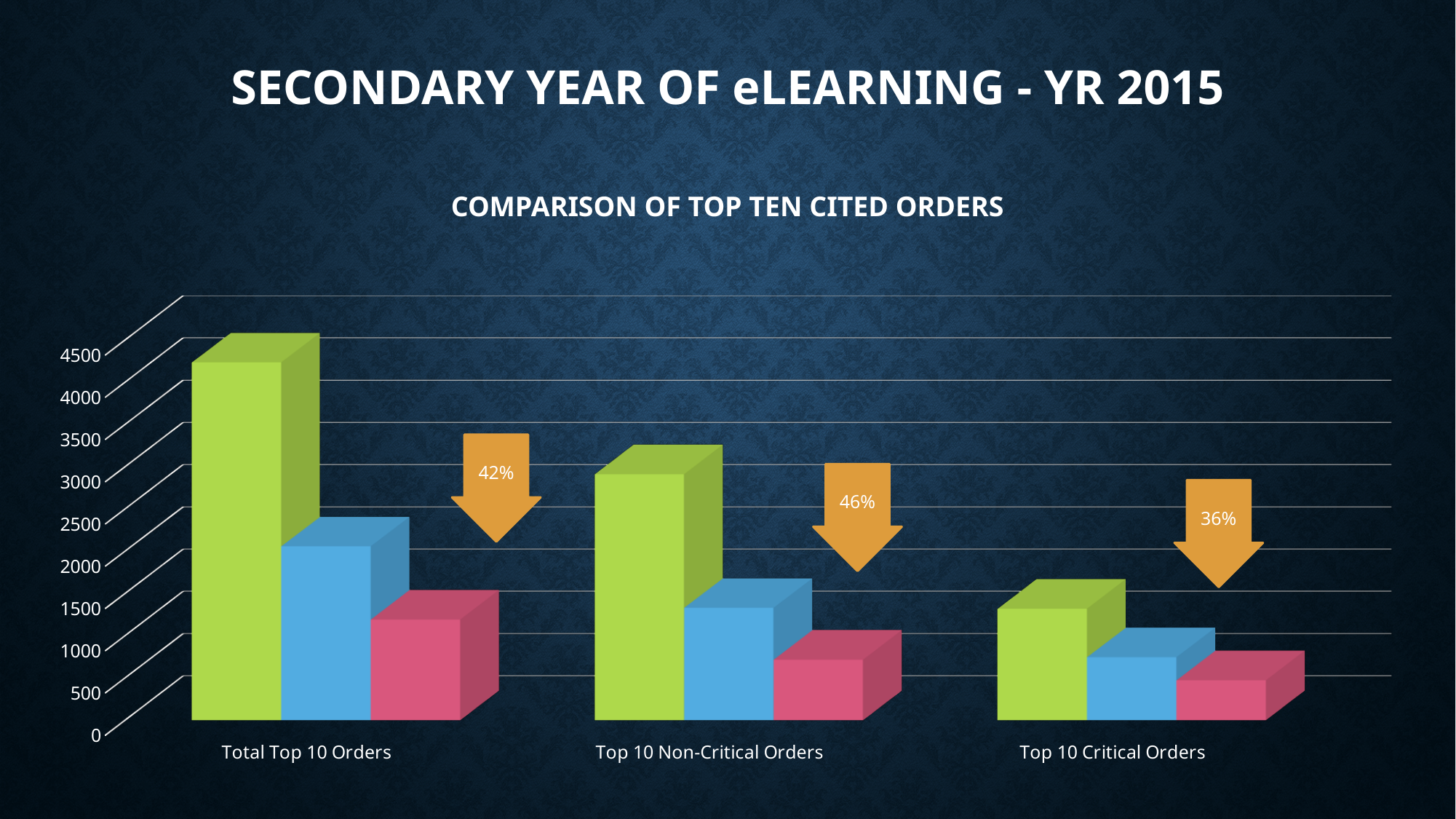
Which category has the tallest bar in the chart? Total Top 10 Orders What is the title of the chart? COMPARISON OF TOP TEN CITED ORDERS Is the value of the green bar for Top 10 Critical Orders greater or less than 2000? less What kind of chart is shown on the slide? bar chart Which category has the shortest bars in the chart? Top 10 Critical Orders What percentage is shown in the arrow above the Top 10 Non-Critical Orders category? 46% How many categories are shown on the x axis of the chart? 3 How many bars are plotted for each category in the chart? 3 Which is larger: the green bar for Top 10 Non-Critical Orders or the green bar for Top 10 Critical Orders? Top 10 Non-Critical Orders Is the value of the green bar for Total Top 10 Orders greater or less than 4000? greater Is the value of the blue bar for Top 10 Non-Critical Orders greater or less than 2000? less What percentage is shown in the arrow above the Top 10 Critical Orders category? 36%